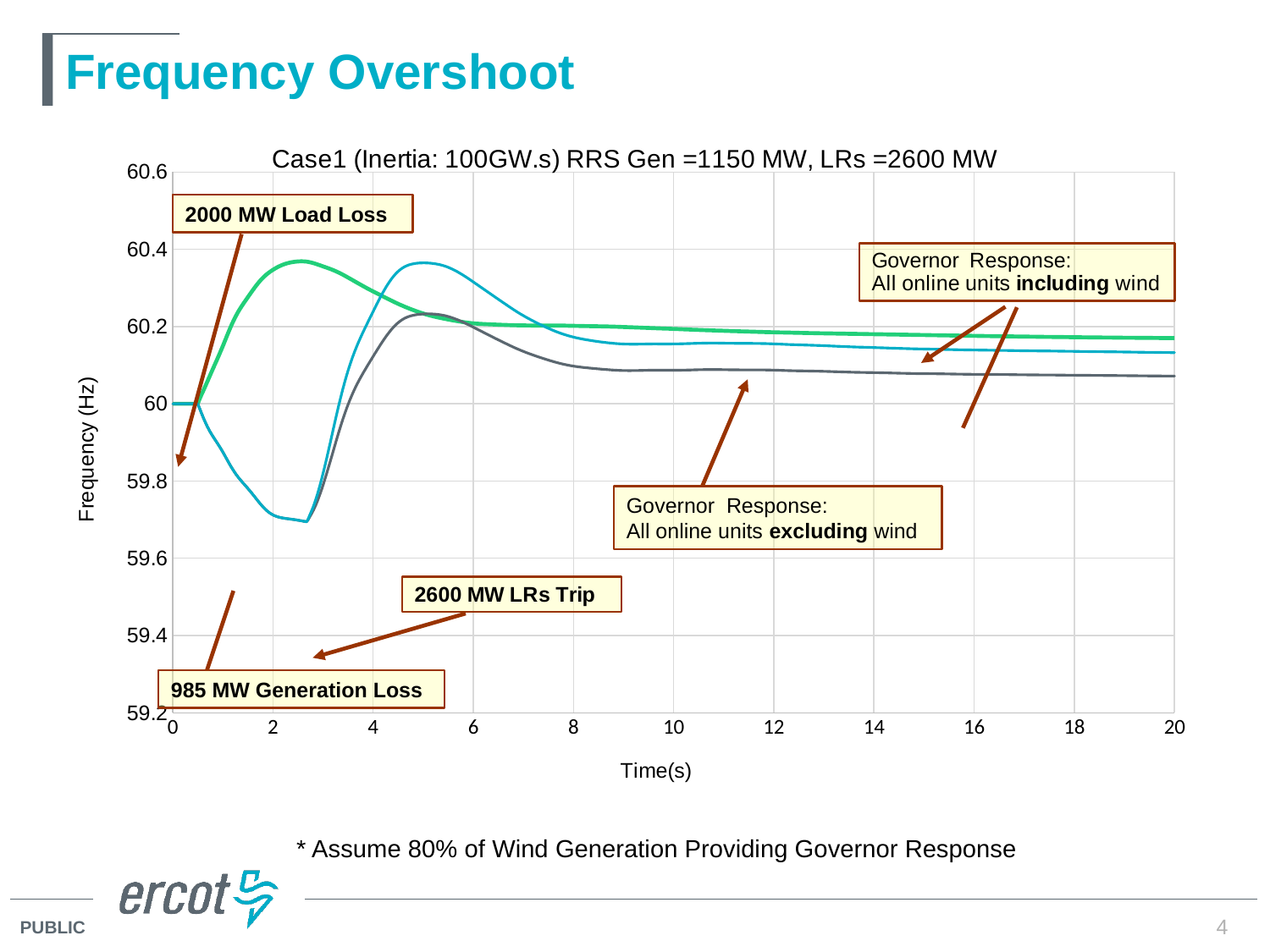
How many lines are plotted on the chart? 3 Does the green line rise or fall between about 3 seconds and 20 seconds? Fall What is the title of the chart? Case1 (Inertia: 100GW.s) RRS Gen =1150 MW, LRs =2600 MW Is the lowest value of the blue line greater or less than 59.8 Hz? less At 20 seconds, which line has the higher frequency, the green line or the dark gray line? The green line Is the peak value of the green line greater or less than 60.2 Hz? greater Does the blue line rise or fall between 0 and about 2.5 seconds? Fall What is the label of the vertical axis of the chart? Frequency (Hz) Is the value of the dark gray line at 20 seconds greater or less than 60 Hz? greater What kind of chart is shown on the slide? Line chart